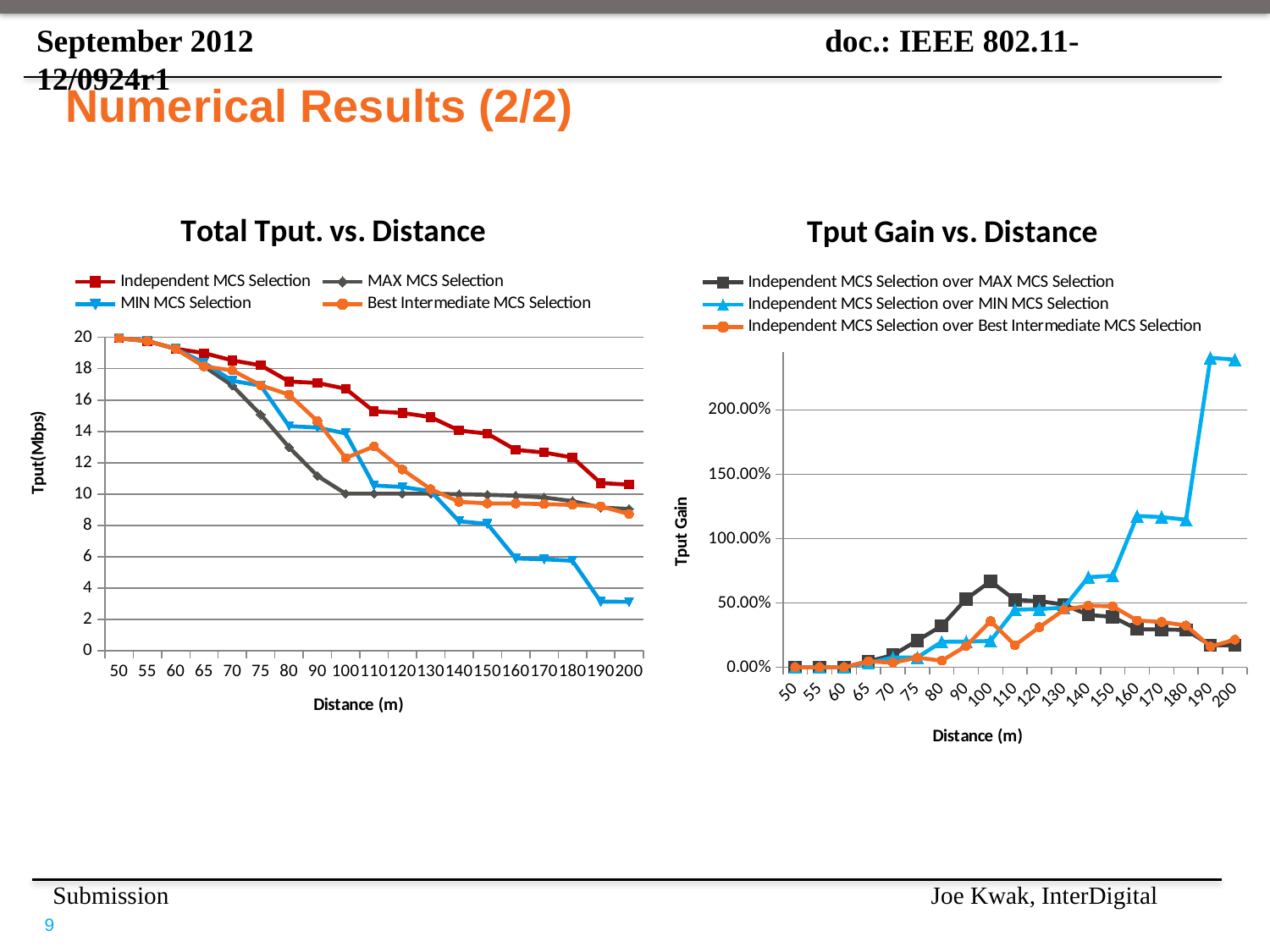
In the 'Total Tput. vs. Distance' chart, do the values for Independent MCS Selection rise or fall as distance increases? fall In the 'Total Tput. vs. Distance' chart, which series has the highest value at 200 m? Independent MCS Selection How many series does the legend of the 'Tput Gain vs. Distance' chart list? 3 In the 'Total Tput. vs. Distance' chart, at 100 m, which is larger: Independent MCS Selection or MAX MCS Selection? Independent MCS Selection In the 'Total Tput. vs. Distance' chart, which series has the lowest value at 200 m? MIN MCS Selection In the 'Tput Gain vs. Distance' chart, is the value for Independent MCS Selection over MIN MCS Selection at 190 m greater or less than 200.00%? greater In the 'Total Tput. vs. Distance' chart, is the value for MAX MCS Selection at 100 m greater or less than 12? less In the 'Total Tput. vs. Distance' chart, is the value for Independent MCS Selection at 200 m greater or less than 12? less How many series does the legend of the 'Total Tput. vs. Distance' chart list? 4 What kind of chart is the 'Total Tput. vs. Distance' chart? line chart How many distance points are plotted along the x axis of the 'Total Tput. vs. Distance' chart? 19